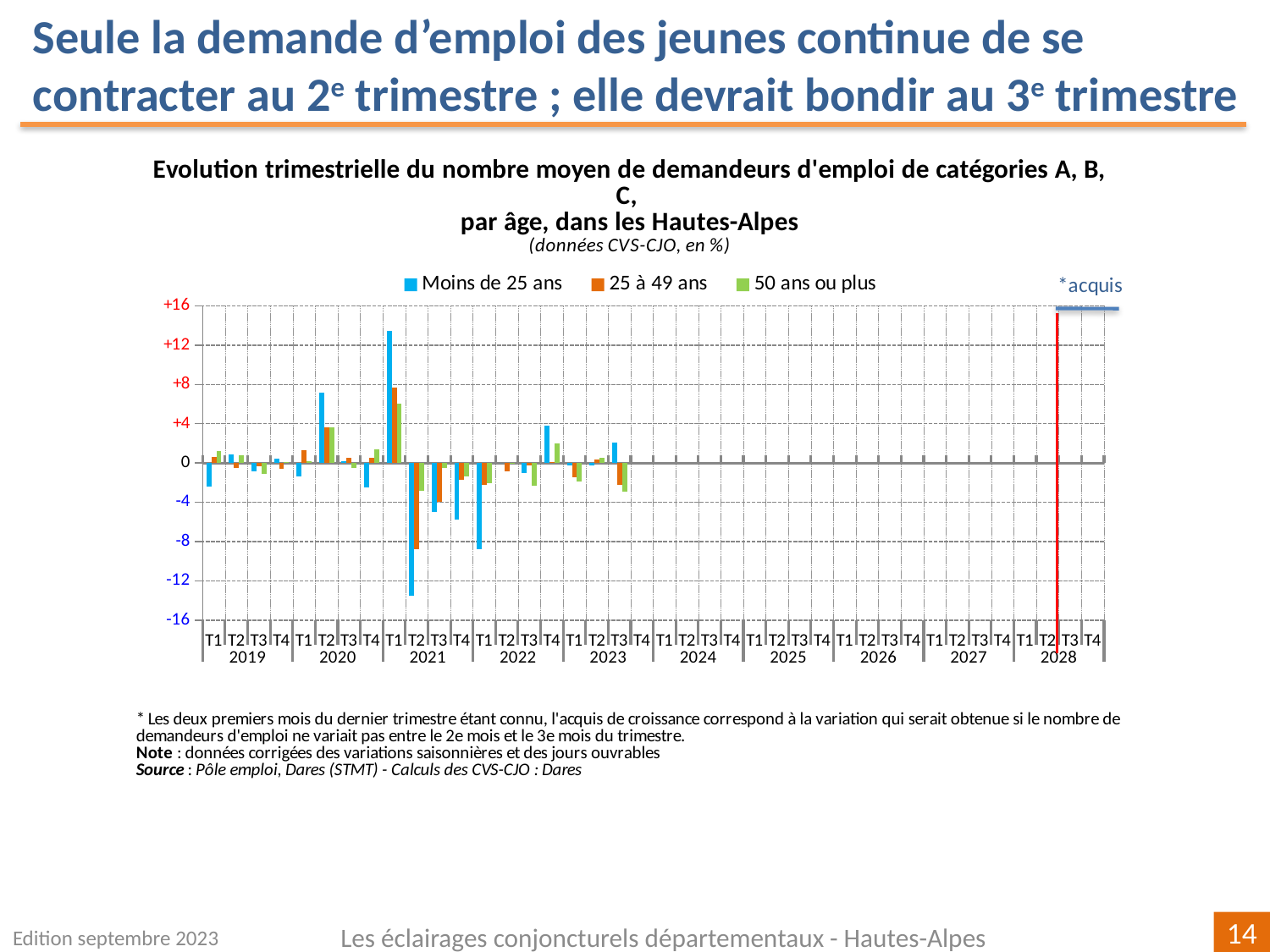
In which quarter does the 'Moins de 25 ans' series reach its highest value? T1 2021 What kind of chart is shown on the slide? bar chart Is the value for 'Moins de 25 ans' in T2 2020 greater or less than +4? greater In which quarter does the 'Moins de 25 ans' series reach its lowest value? T2 2021 In T1 2021, which series has the larger value: 'Moins de 25 ans' or '25 à 49 ans'? Moins de 25 ans Which series does the legend list first? Moins de 25 ans How many series does the legend list? 3 Is the value for 'Moins de 25 ans' in T1 2021 greater or less than +12? greater What colour are the bars for the '50 ans ou plus' series? green How many years are labelled along the x axis? 10 Is the value for '25 à 49 ans' in T2 2021 greater or less than -8? less